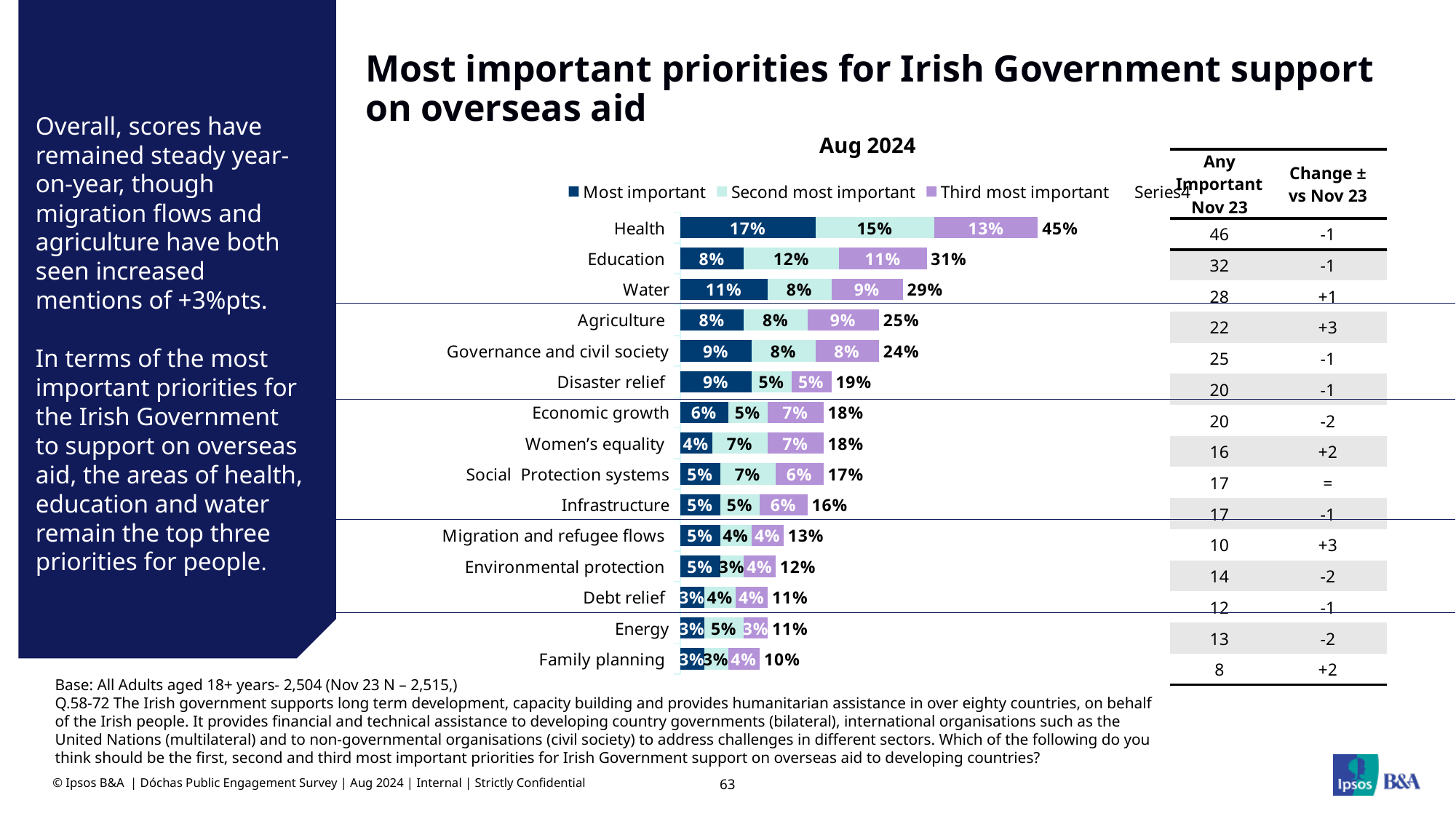
What is the total of the stacked bar for Disaster relief? 19% How many priority categories are plotted in the chart? 15 Which has a larger total value, Water or Agriculture? Water What is the 'Third most important' value for Agriculture? 9% What is the difference between the total for Health and the total for Education? 14% What is the title of the chart? Most important priorities for Irish Government support on overseas aid What is the 'Most important' value for Health? 17% Which category has the lowest total value? Family planning Which category has the highest total value? Health What is the 'Second most important' value for Water? 8% What is the total value shown at the end of the Education bar? 31% What kind of chart is shown on the slide? Stacked bar chart